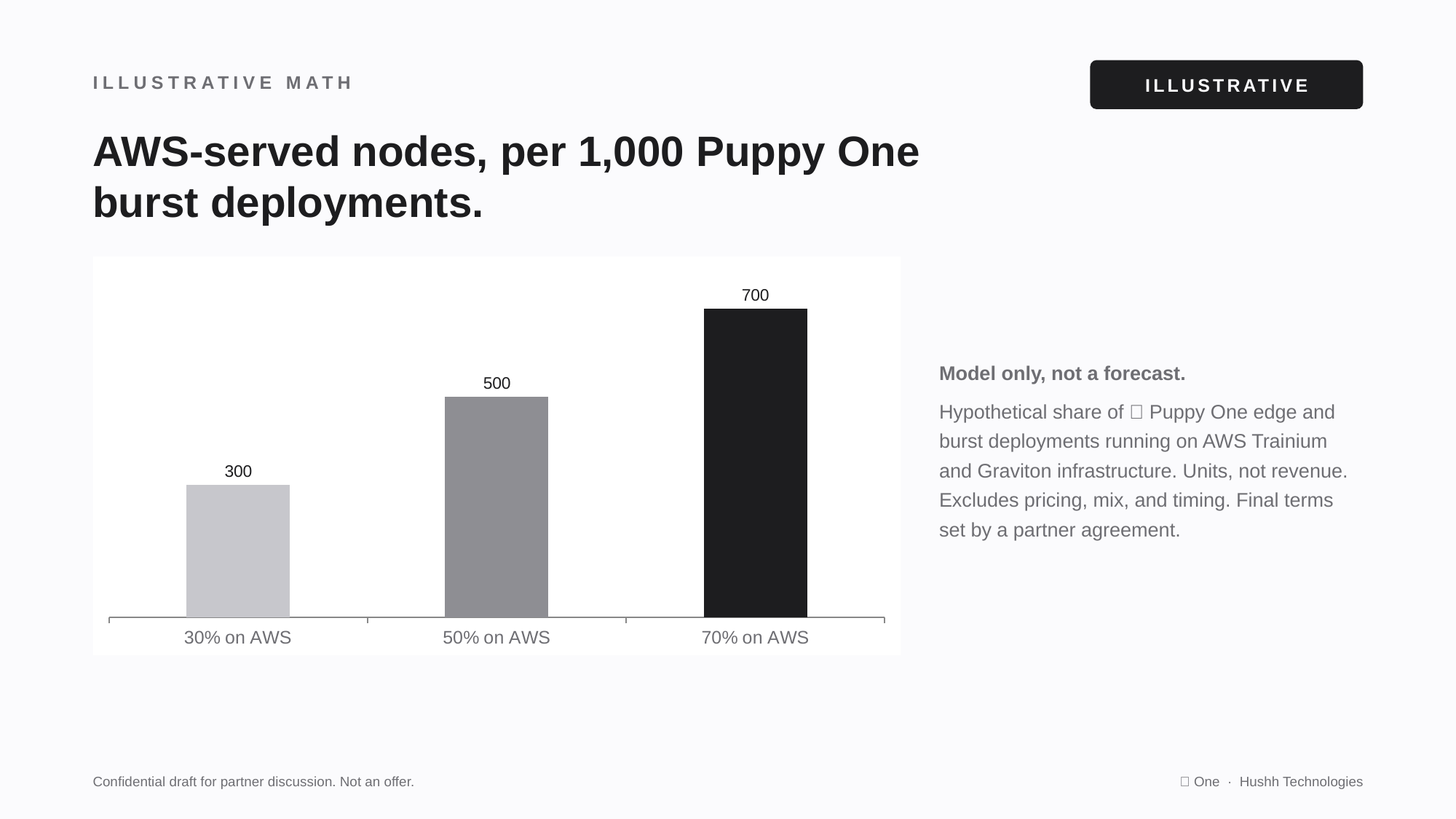
What is the difference between the values for 70% on AWS and 30% on AWS? 400 What is the difference between the values for 50% on AWS and 30% on AWS? 200 How many categories are shown on the chart? 3 What is the value for 30% on AWS? 300 Which category has the lowest value? 30% on AWS What kind of chart is shown on the slide? Bar chart What is the value for 70% on AWS? 700 Which is larger, the value for 50% on AWS or the value for 70% on AWS? 70% on AWS Which category has the highest value? 70% on AWS What is the value for 50% on AWS? 500 Do the values rise or fall from left to right across the categories? Rise What is the title of the chart on the slide? AWS-served nodes, per 1,000 Puppy One burst deployments.